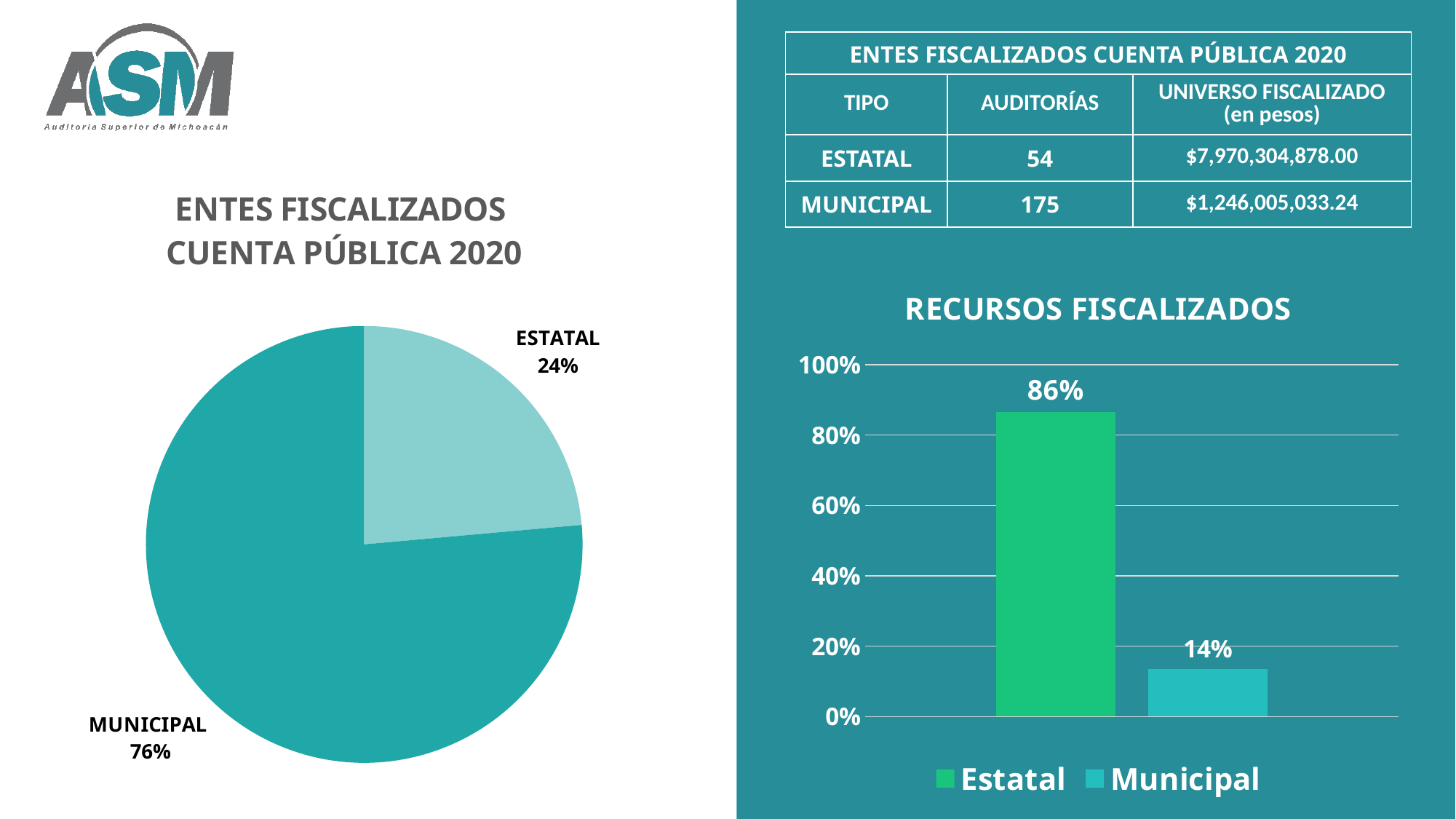
What kind of chart is 'RECURSOS FISCALIZADOS'? Bar chart In the 'RECURSOS FISCALIZADOS' chart, what is the difference in percentage points between Estatal and Municipal? 72 In the pie chart 'ENTES FISCALIZADOS CUENTA PÚBLICA 2020', how many slices are there? 2 In the pie chart 'ENTES FISCALIZADOS CUENTA PÚBLICA 2020', what is the difference in percentage points between MUNICIPAL and ESTATAL? 52 What kind of chart is the one on the left of the slide? Pie chart In the pie chart 'ENTES FISCALIZADOS CUENTA PÚBLICA 2020', what share does MUNICIPAL have? 76% In the 'RECURSOS FISCALIZADOS' chart, which series has the lowest value? Municipal In the pie chart 'ENTES FISCALIZADOS CUENTA PÚBLICA 2020', what share does ESTATAL have? 24% How many series does the legend of the 'RECURSOS FISCALIZADOS' chart list? 2 In the 'RECURSOS FISCALIZADOS' chart, what is the value for Municipal? 14% In the pie chart 'ENTES FISCALIZADOS CUENTA PÚBLICA 2020', which slice is the largest? MUNICIPAL In the 'RECURSOS FISCALIZADOS' chart, what is the value for Estatal? 86%